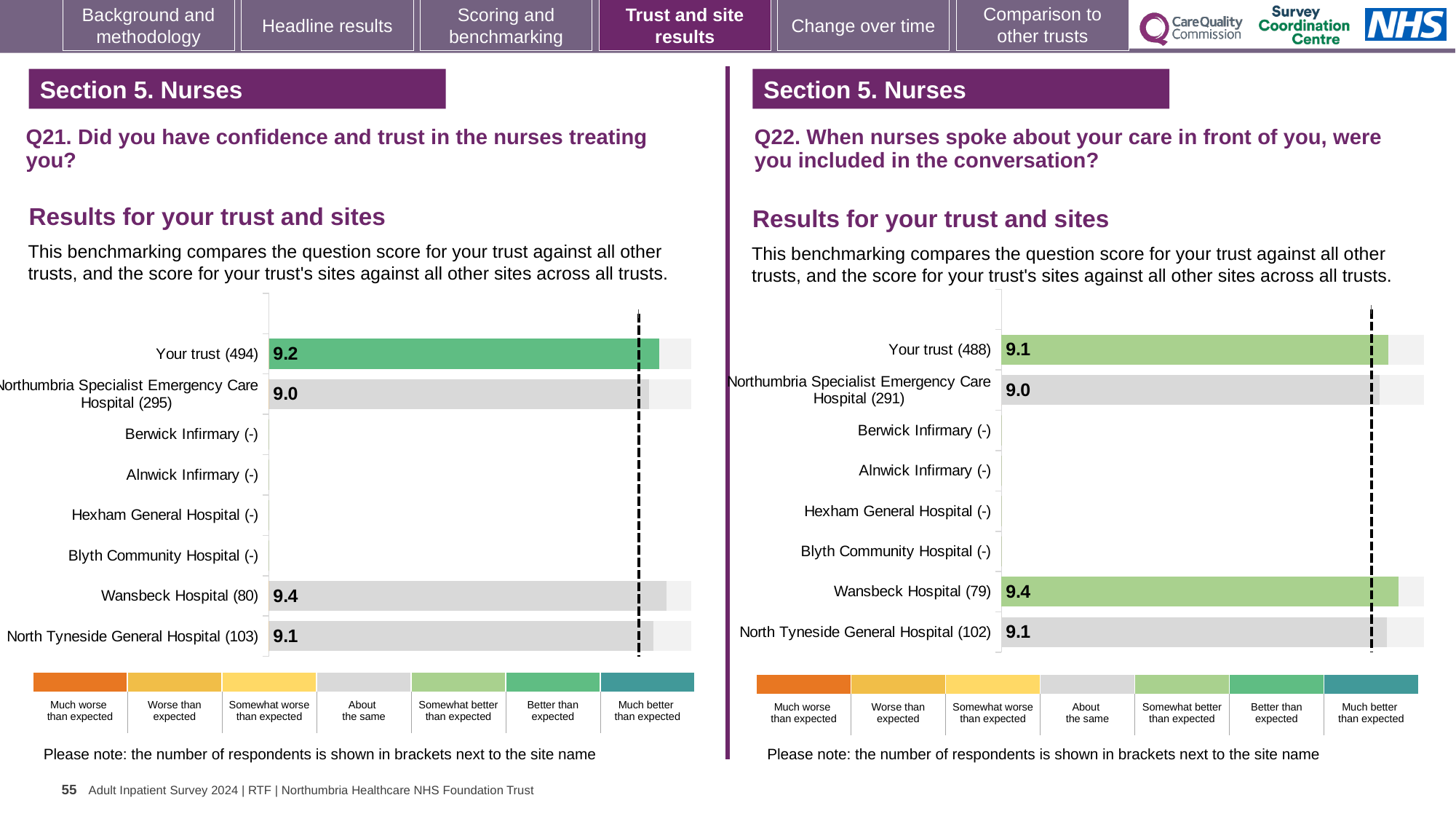
In the Q22 chart (right), how many categories (trust and sites) are listed on the axis? 8 In the Q21 chart (left), what is the difference between the scores for Wansbeck Hospital and North Tyneside General Hospital? 0.3 In the Q21 chart (left), what is the score for Wansbeck Hospital? 9.4 In the Q21 chart (left), what is the score for Your trust? 9.2 In the Q22 chart (right), which site has the highest score? Wansbeck Hospital In the Q22 chart (right), what is the score for Northumbria Specialist Emergency Care Hospital? 9.0 In the Q22 chart (right), what is the score for North Tyneside General Hospital? 9.1 In the Q21 chart (left), how many respondents are shown for Your trust? 494 In the Q21 chart (left), which site with a score shown has the lowest score? Northumbria Specialist Emergency Care Hospital In the Q21 chart (left), which site has the highest score? Wansbeck Hospital What type of chart is used in the Q21 chart (left)? bar chart In the Q22 chart (right), is the score for Your trust larger or smaller than the score for Wansbeck Hospital? smaller